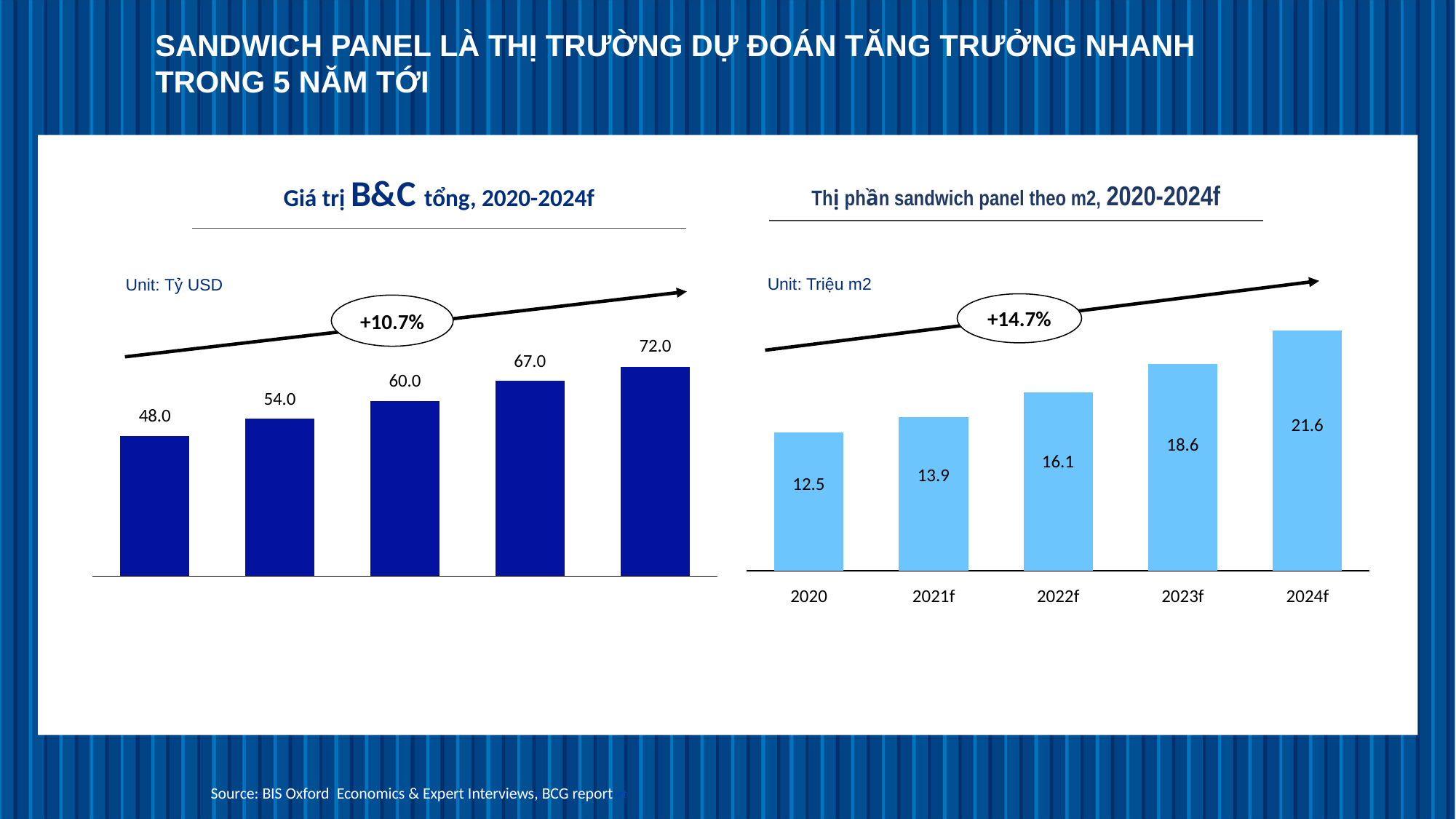
In the chart titled 'Thị phần sandwich panel theo m2, 2020-2024f', what is the value for 2022f? 16.1 In the chart titled 'Giá trị B&C tổng, 2020-2024f', what is the value of the first (leftmost) bar? 48.0 What kind of chart is the chart titled 'Giá trị B&C tổng, 2020-2024f'? bar chart In the chart titled 'Giá trị B&C tổng, 2020-2024f', do the values rise or fall from left to right? rise In the chart titled 'Thị phần sandwich panel theo m2, 2020-2024f', what is the value for 2024f? 21.6 In the chart titled 'Thị phần sandwich panel theo m2, 2020-2024f', what is the difference between the values for 2024f and 2020? 9.1 What growth rate is shown in the oval on the chart titled 'Thị phần sandwich panel theo m2, 2020-2024f'? +14.7% In the chart titled 'Giá trị B&C tổng, 2020-2024f', what is the value of the tallest bar? 72.0 In the chart titled 'Thị phần sandwich panel theo m2, 2020-2024f', is the value for 2023f greater or less than the value for 2021f? greater In the chart titled 'Thị phần sandwich panel theo m2, 2020-2024f', how many bars are plotted? 5 In the chart titled 'Thị phần sandwich panel theo m2, 2020-2024f', which year has the lowest value? 2020 In the chart titled 'Giá trị B&C tổng, 2020-2024f', what is the difference between the last bar and the first bar? 24.0